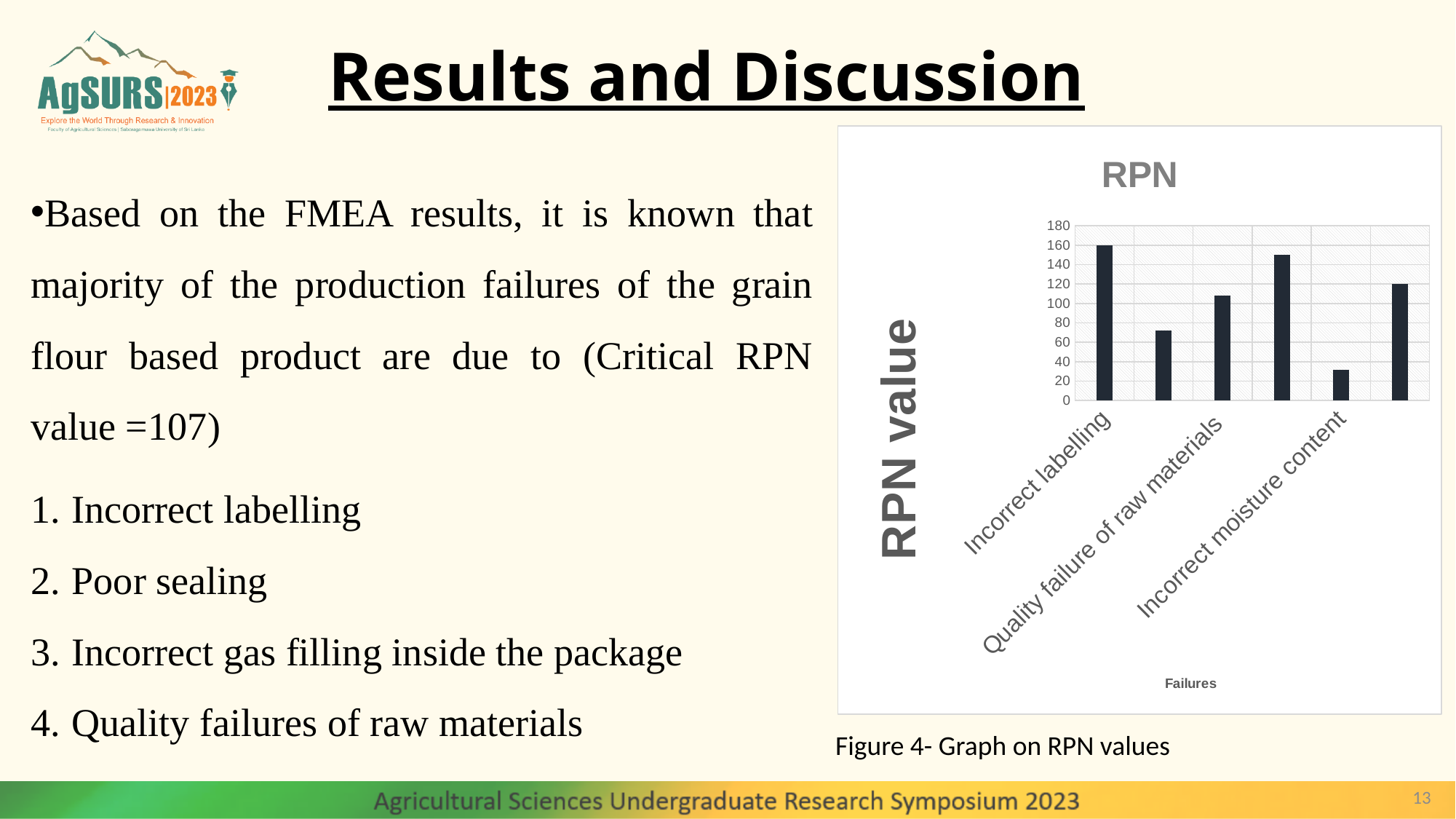
Which labelled failure has the lowest RPN value? Incorrect moisture content How many bars are plotted in the RPN chart? 6 Which has a higher RPN value, Quality failure of raw materials or Incorrect moisture content? Quality failure of raw materials What is the RPN value for Incorrect labelling? 160 What is the label on the vertical axis of the chart? RPN value Which labelled failure has the highest RPN value? Incorrect labelling Is the RPN value for Quality failure of raw materials greater or less than 100? greater Which has a higher RPN value, Incorrect labelling or Quality failure of raw materials? Incorrect labelling What is the title of the chart? RPN What kind of chart is shown on the slide? bar chart Is the RPN value for Incorrect labelling greater or less than 140? greater Is the RPN value for Incorrect moisture content greater or less than 40? less